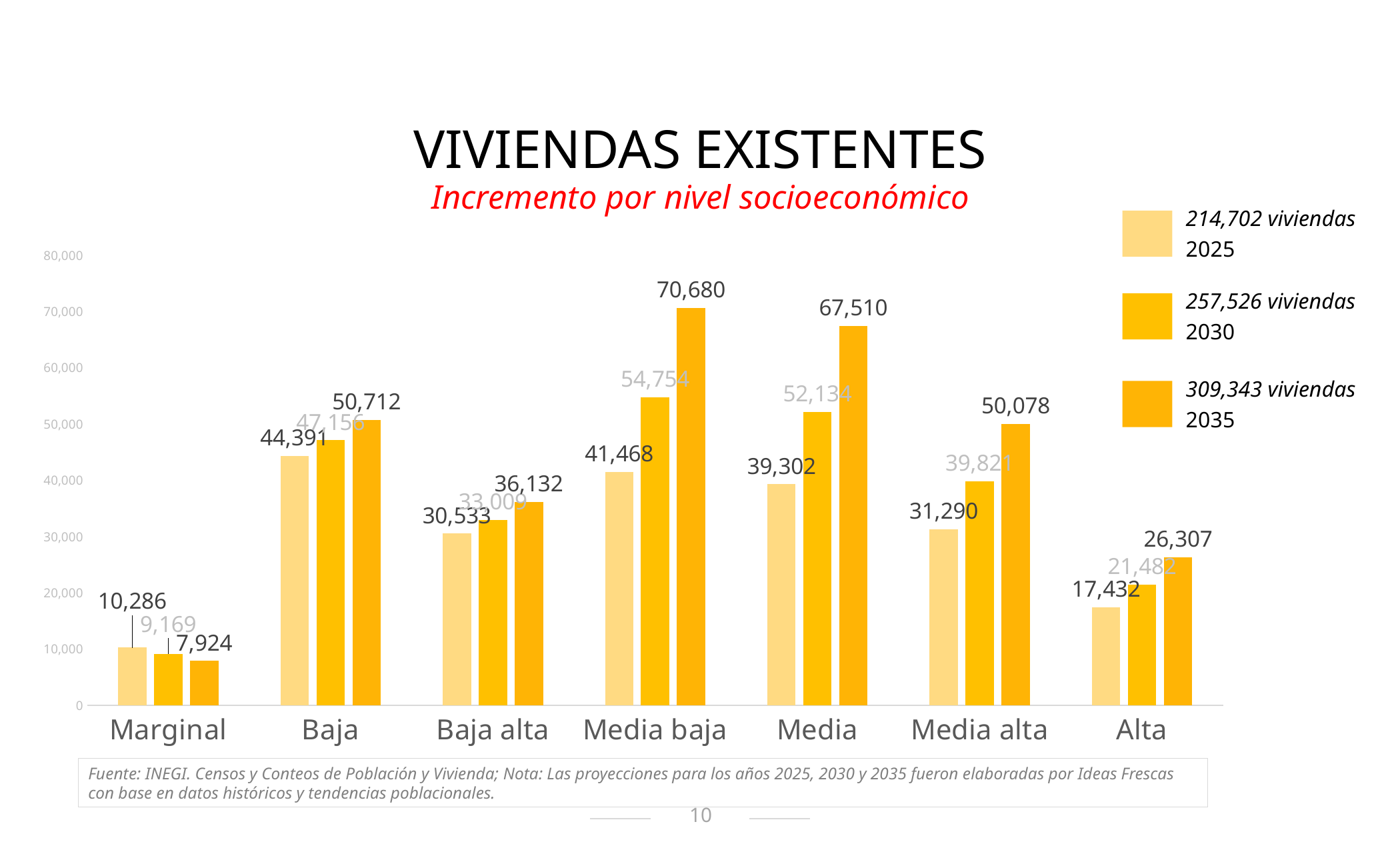
How many series does the legend list? 3 What is the 2030 value for Media alta? 39,821 What is the 2025 value for Marginal? 10,286 Which is larger for Alta: the 2030 value or the 2035 value? 2035 What kind of chart is shown on the slide? bar chart What is the 2035 value for Media baja? 70,680 How many socioeconomic levels are shown on the x axis? 7 What total number of viviendas does the legend give for 2035? 309,343 viviendas Which socioeconomic level has the highest 2035 value? Media baja What is the difference between the 2035 and 2025 values for Media baja? 29,212 Which socioeconomic level has the lowest 2025 value? Marginal Is the 2035 value for Media greater or less than 60,000? greater